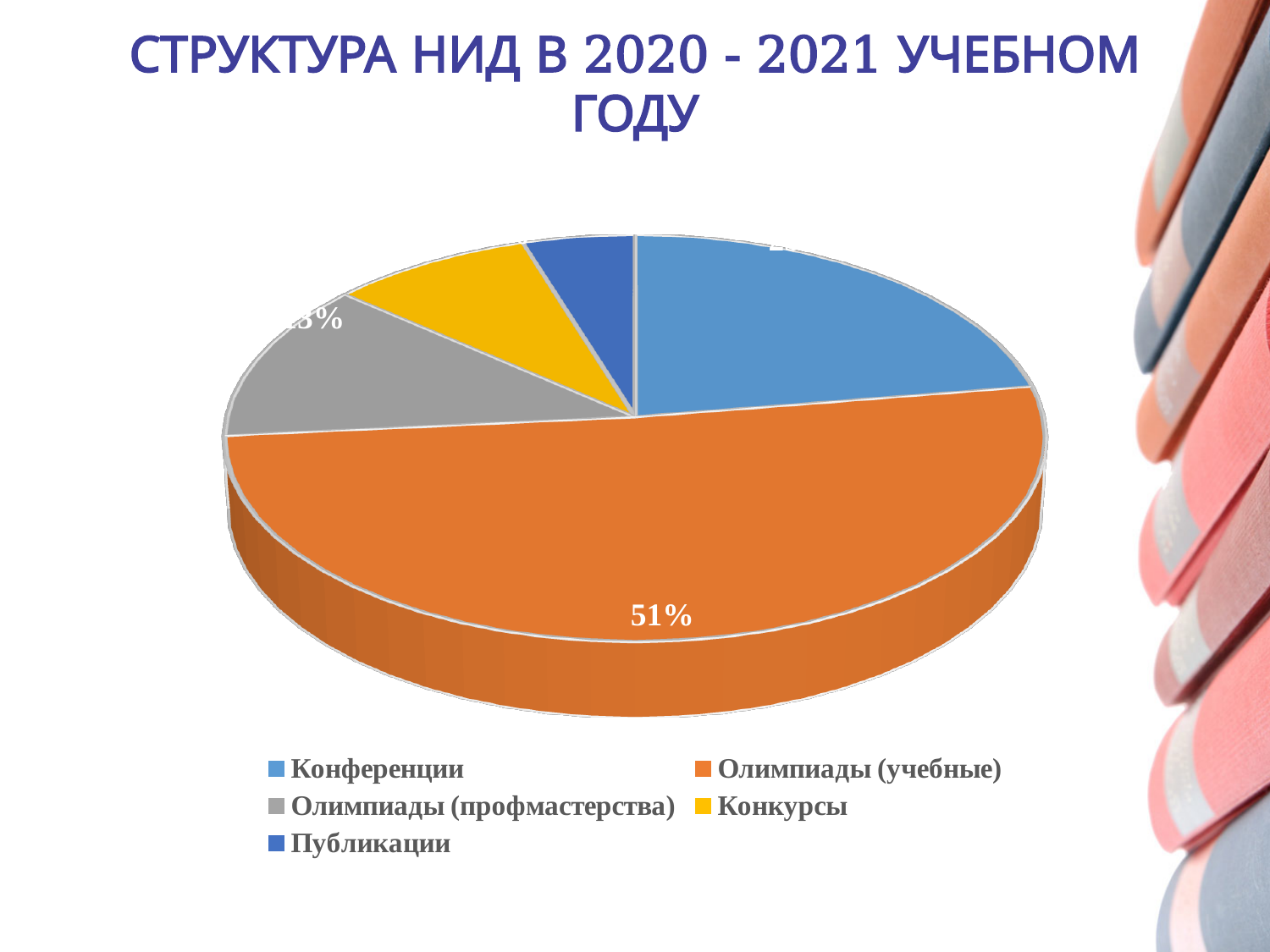
Which category has the smallest slice of the pie? Публикации Which slice is larger: Конкурсы or Публикации? Конкурсы What is the title of the slide? СТРУКТУРА НИД В 2020 - 2021 УЧЕБНОМ ГОДУ Which slice is larger: Конференции or Конкурсы? Конференции Does Олимпиады (учебные) make up more or less than half of the pie? More What share of the pie does Олимпиады (учебные) account for? 51% How many categories does the pie chart show? 5 What kind of chart is shown on the slide? Pie chart Which category has the largest slice of the pie? Олимпиады (учебные) Which category is shown in orange in the legend? Олимпиады (учебные) Which slice is larger: Олимпиады (профмастерства) or Публикации? Олимпиады (профмастерства)